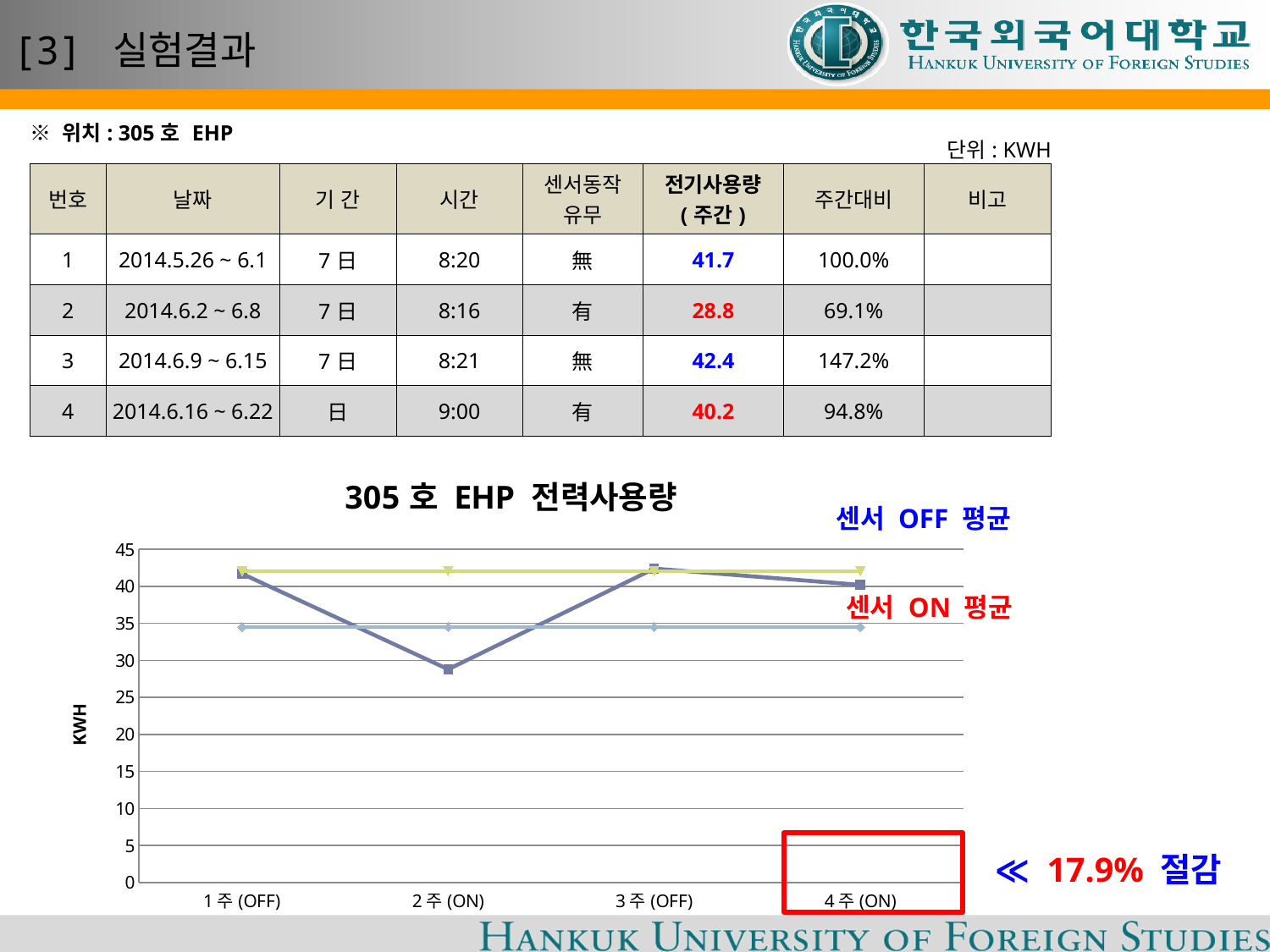
Is the value for 2주 (ON) in the '305 호 EHP 전력사용량' chart greater or less than 30? less Is the value for 1주 (OFF) in the '305 호 EHP 전력사용량' chart greater or less than 40? greater What kind of chart is shown under the title '305 호 EHP 전력사용량'? line chart Is the value for 4주 (ON) in the '305 호 EHP 전력사용량' chart greater or less than 35? greater In the '305 호 EHP 전력사용량' chart, which is larger, the value for 2주 (ON) or 4주 (ON)? 4주 (ON) Does the power usage rise or fall from 1주 (OFF) to 2주 (ON) in the '305 호 EHP 전력사용량' chart? fall Which week has the lowest power usage in the '305 호 EHP 전력사용량' chart? 2주 (ON) What is the label on the y axis of the '305 호 EHP 전력사용량' chart? KWH What savings percentage is annotated next to the red box on the chart? 17.9% How many weekly points are plotted along the x axis of the '305 호 EHP 전력사용량' chart? 4